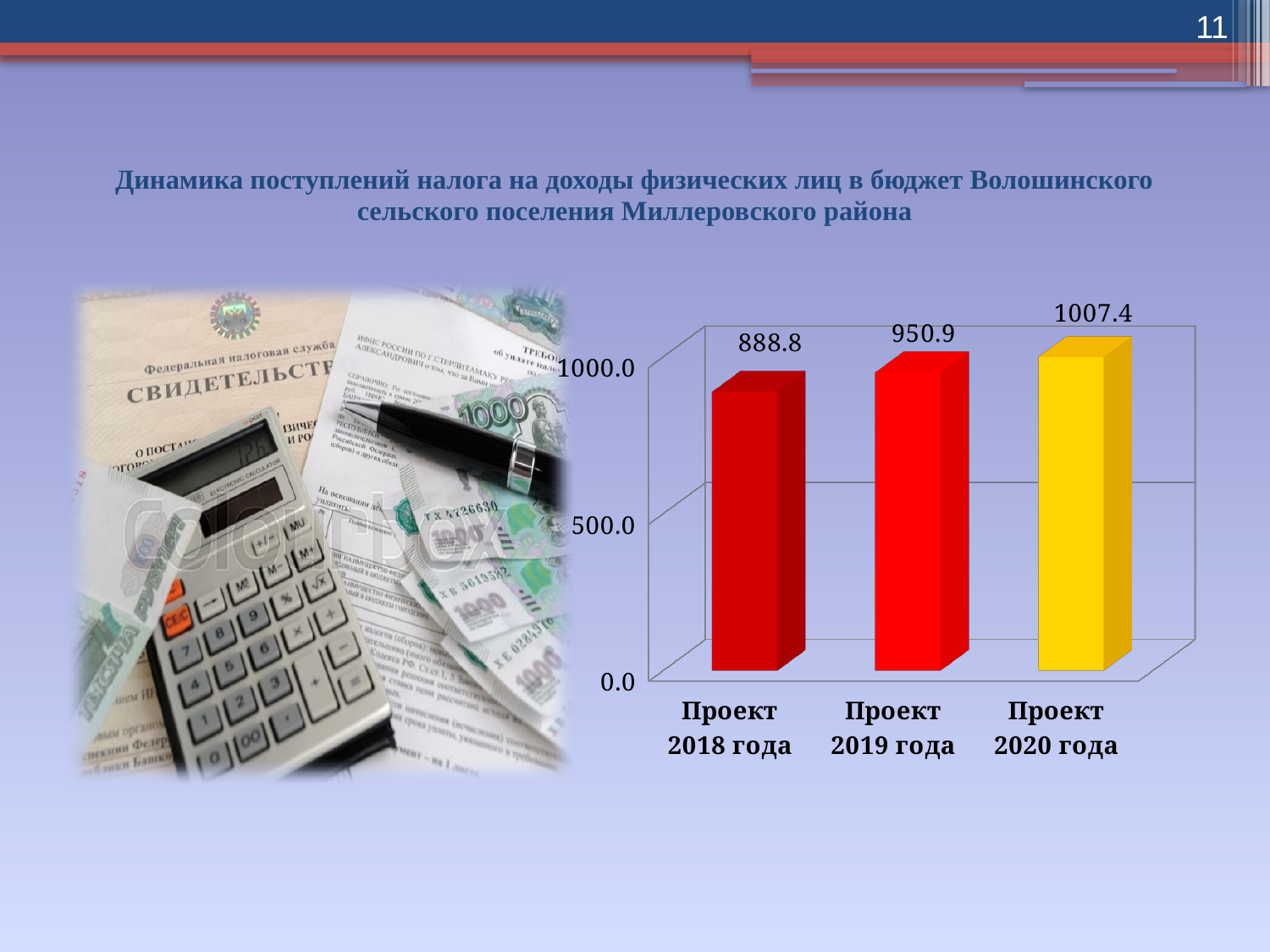
Which is larger, the value for Проект 2019 года or Проект 2020 года? Проект 2020 года What is the value for Проект 2018 года? 888.8 Which category has the lowest value? Проект 2018 года What kind of chart is shown on the slide? bar chart What is the value for Проект 2020 года? 1007.4 What is the difference between the values for Проект 2019 года and Проект 2018 года? 62.1 What is the difference between the values for Проект 2020 года and Проект 2018 года? 118.6 How many categories are shown in the chart? 3 Do the values rise or fall from Проект 2018 года to Проект 2020 года? rise Which category has the highest value? Проект 2020 года What is the value for Проект 2019 года? 950.9 Is the value for Проект 2018 года greater or less than 1000.0? less